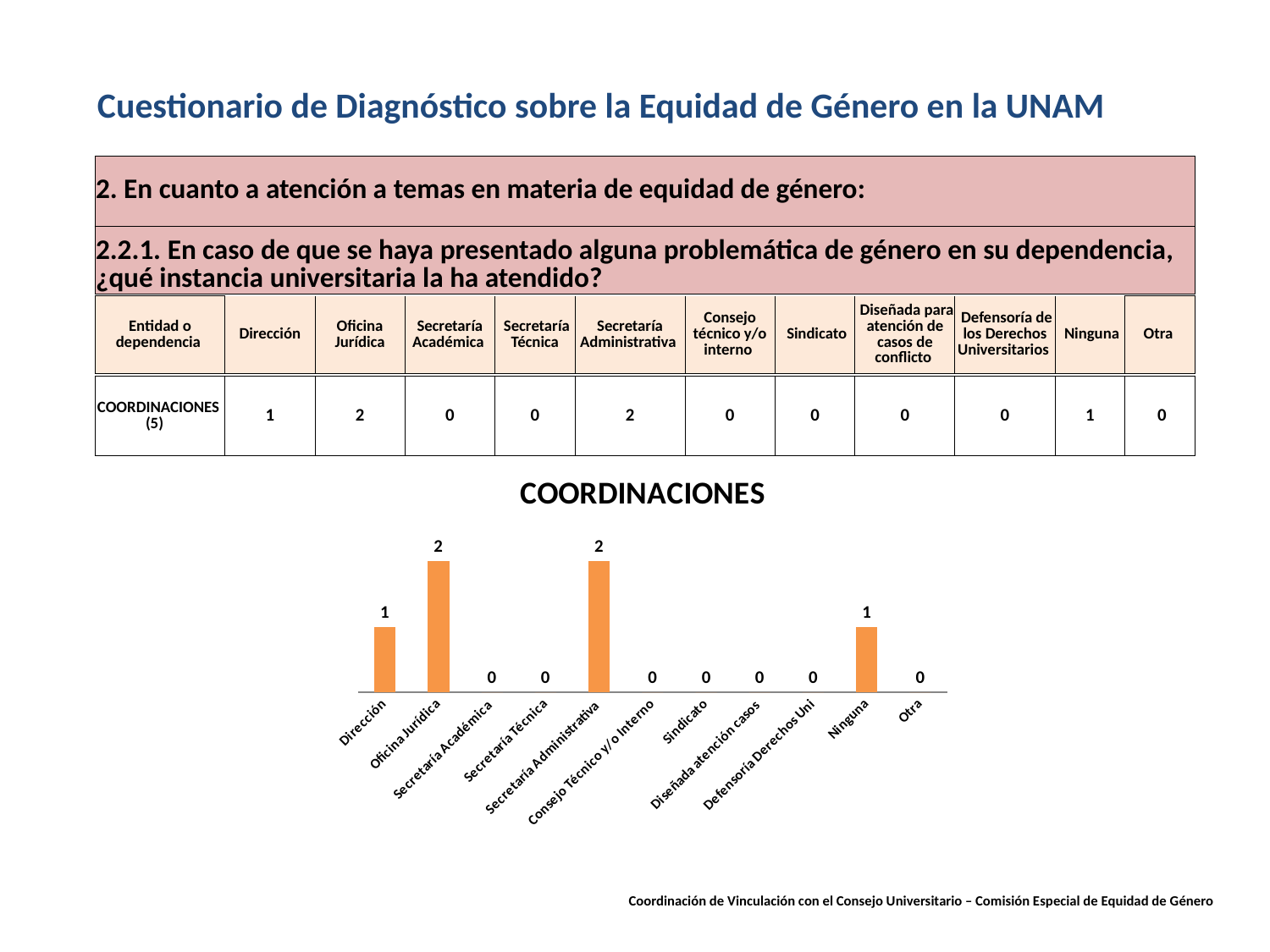
What is the value for Secretaría Administrativa in the COORDINACIONES chart? 2 What is the value for Sindicato in the COORDINACIONES chart? 0 What is the value for Ninguna in the COORDINACIONES chart? 1 What is the difference between the values for Oficina Jurídica and Dirección in the COORDINACIONES chart? 1 How many categories are shown on the x axis of the COORDINACIONES chart? 11 How many categories in the COORDINACIONES chart have a value of 0? 7 What is the value for Oficina Jurídica in the COORDINACIONES chart? 2 Is the value for Oficina Jurídica larger than the value for Ninguna in the COORDINACIONES chart? Yes What is the value for Dirección in the COORDINACIONES chart? 1 What type of chart is the COORDINACIONES chart? Bar chart What is the title of the chart on the slide? COORDINACIONES Which category has the lowest value in the COORDINACIONES chart, Dirección or Secretaría Técnica? Secretaría Técnica